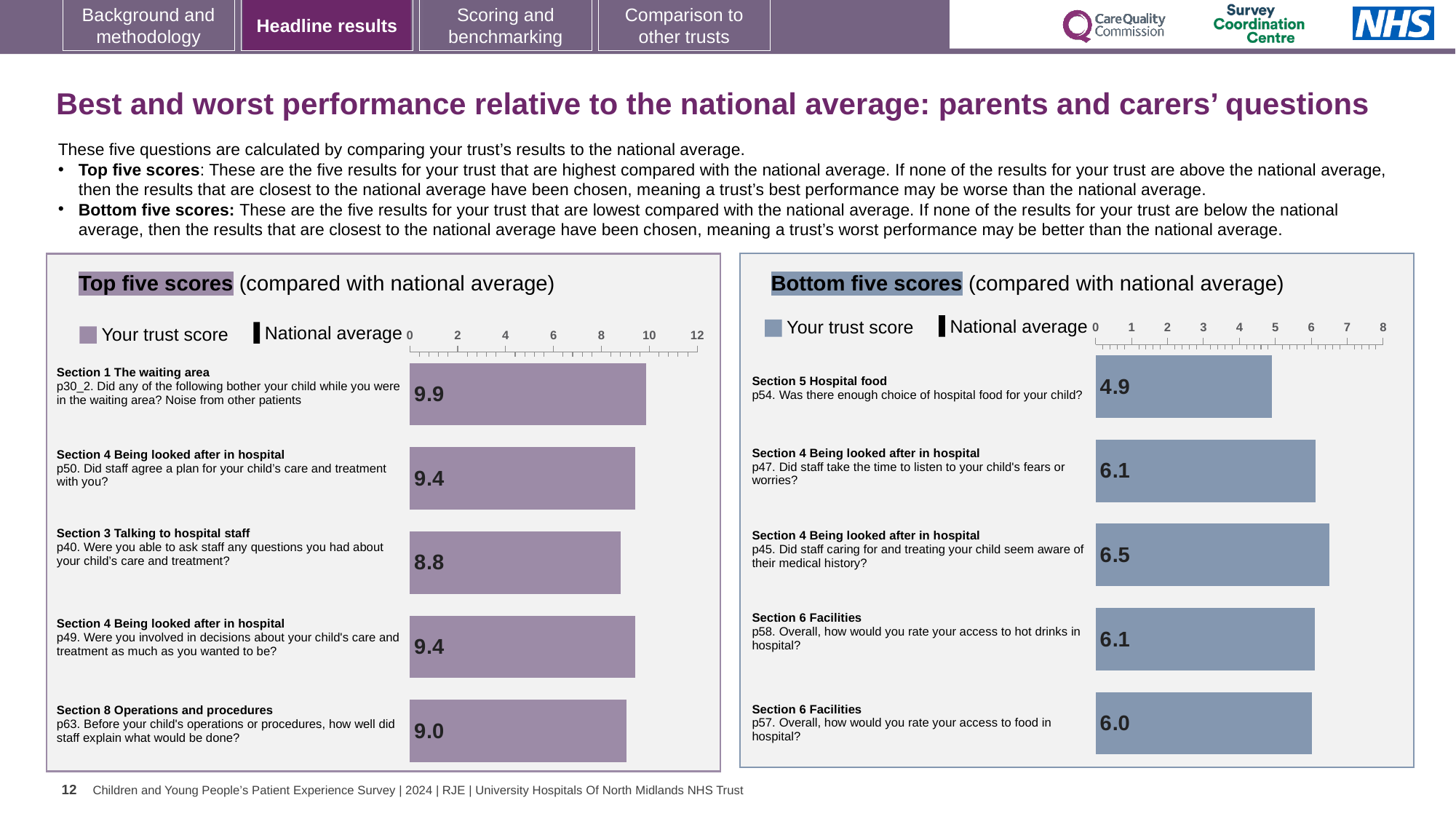
In the Top five scores chart, which question has the lowest trust score? p40 (able to ask staff any questions about your child's care and treatment) In the Bottom five scores chart, what is the difference between the trust scores for p45 and p54? 1.6 In the Bottom five scores chart, what is the trust score for p54 (enough choice of hospital food)? 4.9 In the Bottom five scores chart, is the trust score for p57 (access to food in hospital) greater or less than 5? greater In the Top five scores chart, which question has the highest trust score? p30_2 (noise from other patients in the waiting area) In the Bottom five scores chart, which question has the lowest trust score? p54 (enough choice of hospital food) In the Top five scores chart, what is the difference between the trust scores for p30_2 and p63? 0.9 In the Top five scores chart, what is the trust score for p30_2 (noise from other patients in the waiting area)? 9.9 In the Bottom five scores chart, what is the trust score for p45 (staff aware of your child's medical history)? 6.5 In the Top five scores chart, what is the trust score for p40 (able to ask staff any questions about your child's care and treatment)? 8.8 What kind of chart is used in the Top five scores panel? Bar chart In the Bottom five scores chart, which question has the highest trust score? p45 (staff aware of your child's medical history)